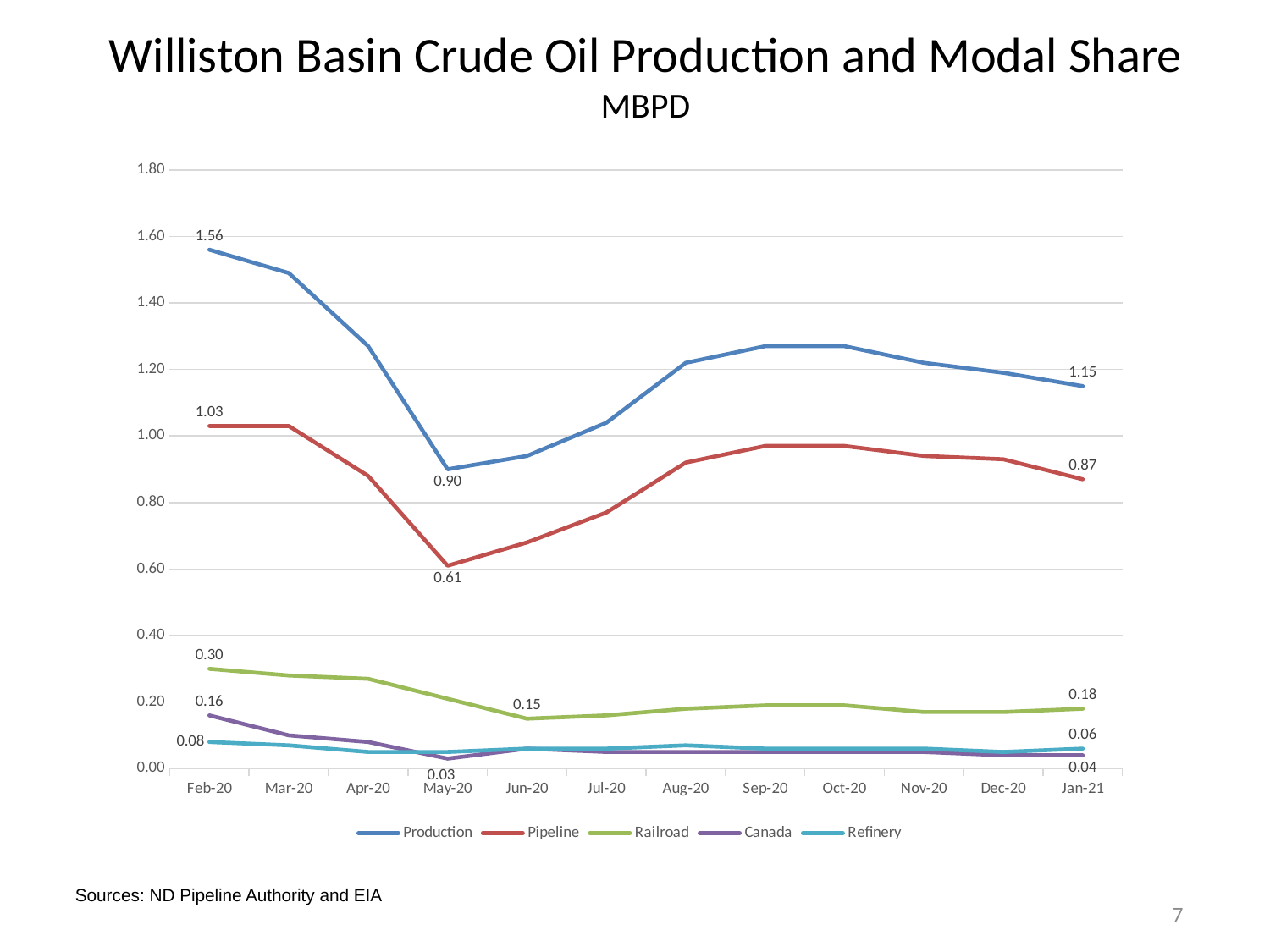
By how much did the Pipeline value fall from Feb-20 to May-20? 0.42 Is the Production value for Sep-20 greater or less than 1.20? greater What is the Pipeline value for May-20? 0.61 What kind of chart is shown on the slide? line chart How many months are shown on the x axis? 12 What is the Railroad value for Jan-21? 0.18 In which month is the Production line at its lowest? May-20 What is the difference between the Production value in Feb-20 and in Jan-21? 0.41 What is the Production value for Feb-20? 1.56 What is the Canada value for May-20? 0.03 Which is larger, the Railroad value in Feb-20 or in Jan-21? Feb-20 How many series does the legend list? 5